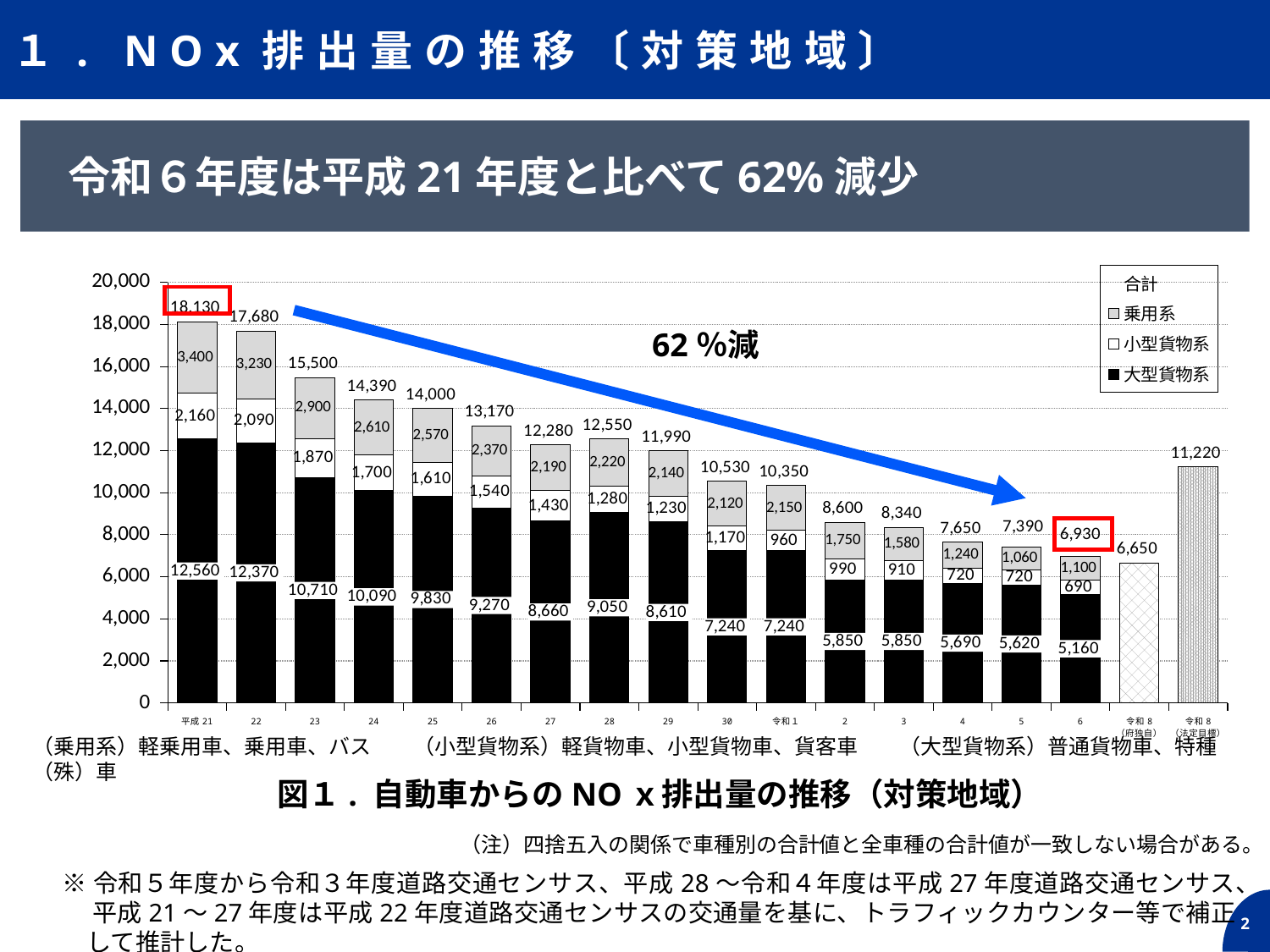
What is the 乗用系 (passenger) value for 平成25? 2,570 Which fiscal year has the highest total NOx emission among the actual (non-target) bars? 平成21 What is the 小型貨物系 (light freight) value for 令和1? 960 Is the 令和8 (法定目標) bar greater or less than 10,000? greater Which fiscal year has the lowest total NOx emission among the actual (non-target) bars from 平成21 to 令和6? 令和6 What kind of chart is shown on the slide? Stacked bar chart Do the total NOx emissions generally rise or fall from 平成21 to 令和6? Fall What is the total NOx emission value shown for 平成21 (Heisei 21)? 18,130 Which is larger, the total for 平成27 or the total for 平成28? 平成28 What is the difference between the total for 平成21 and the total for 令和6? 11,200 What is the 大型貨物系 (heavy freight) value for 令和6? 5,160 How many fiscal years of actual data are plotted from 平成21 through 令和6? 16